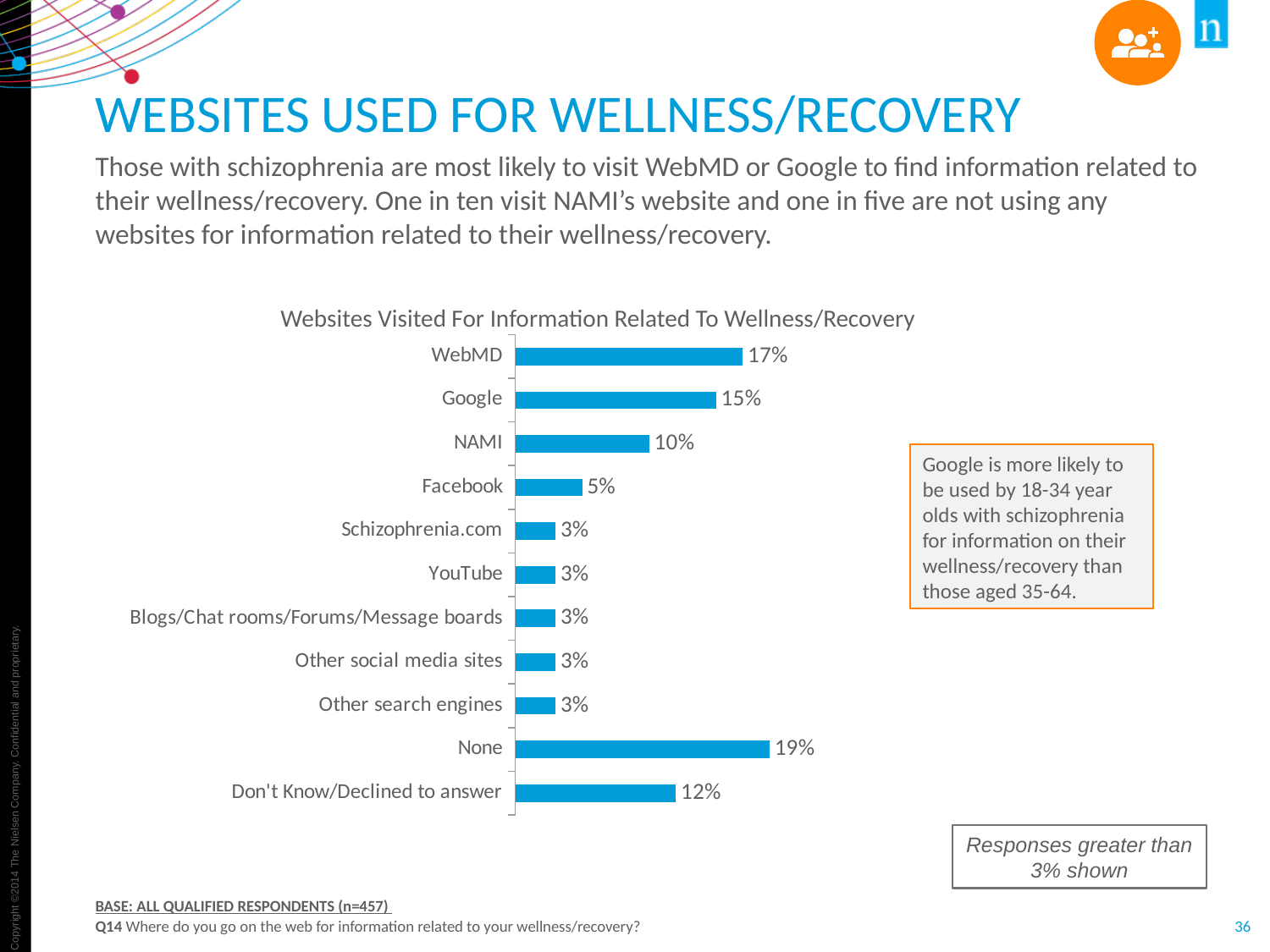
Which category has the highest value? None What is the value for Don't Know/Declined to answer? 12% Which is larger, the value for Facebook or the value for YouTube? Facebook What is the difference between the values for None and NAMI? 9% What is the difference between the values for WebMD and Google? 2% How many categories have a value of 3%? 5 How many categories are shown in the chart? 11 What is the title of the chart? Websites Visited For Information Related To Wellness/Recovery Which is larger, the value for Google or the value for Don't Know/Declined to answer? Google What kind of chart is shown on the slide? Bar chart What is the value for NAMI? 10% What is the value for WebMD? 17%